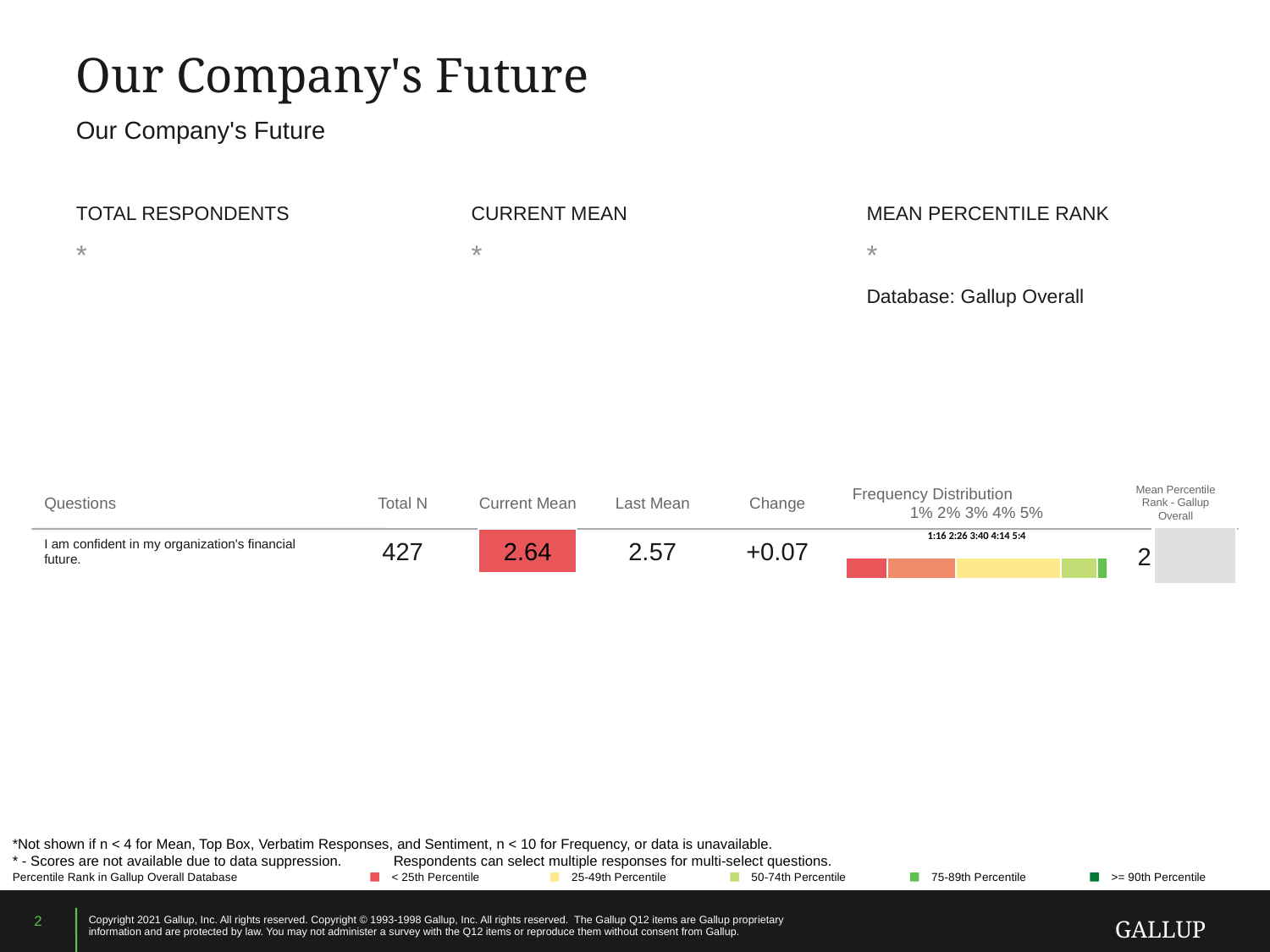
In the Frequency Distribution chart, what colour is the segment for response 3? Yellow What is the Current Mean shown for the question 'I am confident in my organization's financial future.'? 2.64 In the Frequency Distribution chart, what is the value for response 3? 40 What kind of chart is the Frequency Distribution chart? Stacked bar chart In the Frequency Distribution chart, which is larger, the value for response 2 or the value for response 4? 2 How many response categories are shown in the Frequency Distribution chart? 5 In the Frequency Distribution chart, what is the value for response 1? 16 In the Frequency Distribution chart, what is the value for response 5? 4 What is the total of all segments in the Frequency Distribution stacked bar? 100 In the Frequency Distribution chart, what is the difference between the values for response 3 and response 2? 14 In the Frequency Distribution chart, which response category has the lowest value? 5 In the Frequency Distribution chart, which response category has the highest value? 3